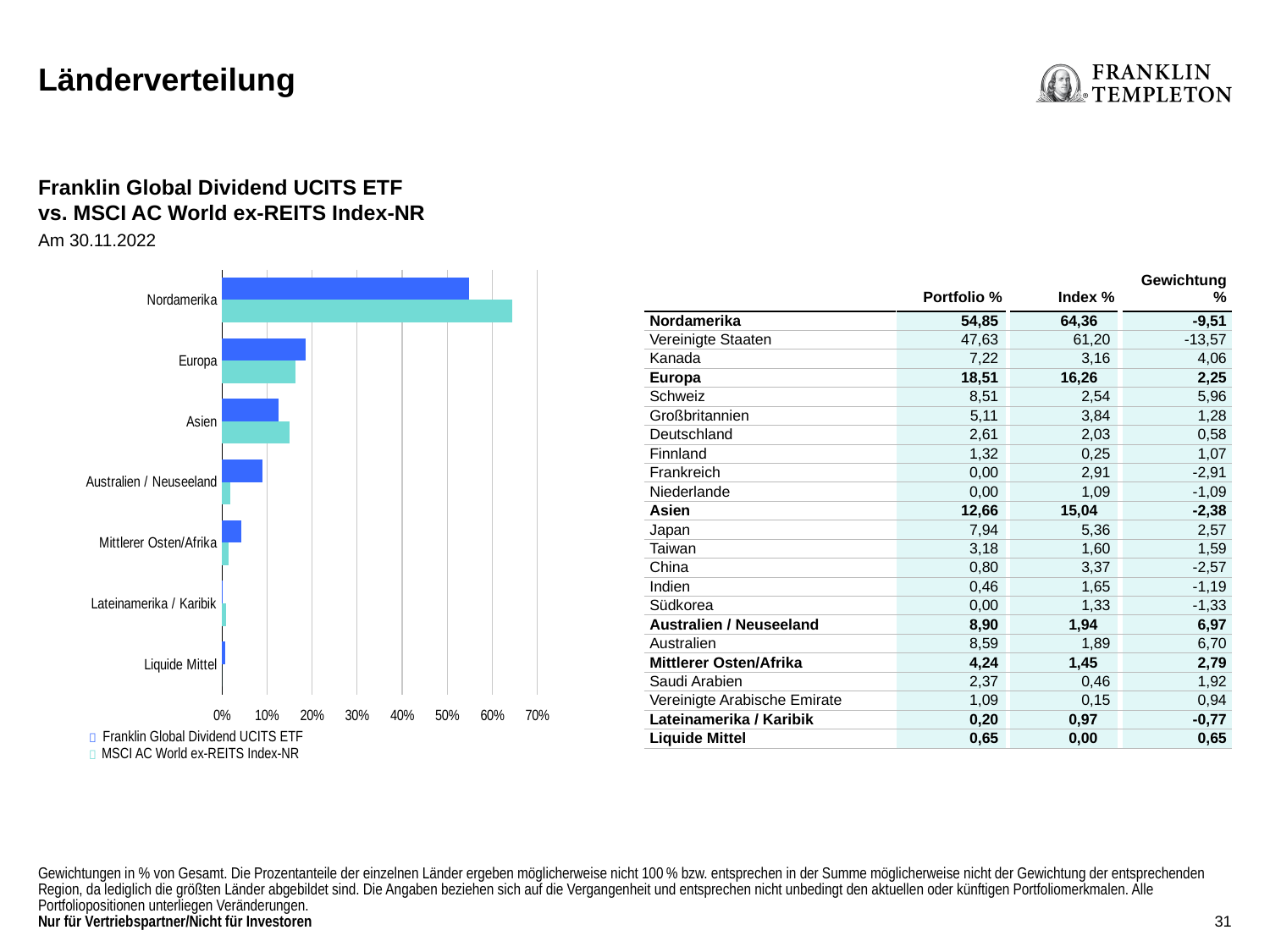
What kind of chart is shown on the slide? bar chart Which category has the highest value for Franklin Global Dividend UCITS ETF? Nordamerika For Australien / Neuseeland, which series has the larger value: Franklin Global Dividend UCITS ETF or MSCI AC World ex-REITS Index-NR? Franklin Global Dividend UCITS ETF Is the value for Nordamerika in the Franklin Global Dividend UCITS ETF series greater or less than 50%? greater According to the table on the slide, what is the Index % for Asien? 15,04 Is the value for Europa in the Franklin Global Dividend UCITS ETF series greater or less than 20%? less According to the table on the slide, what is the Portfolio % for Nordamerika? 54,85 Is the value for Nordamerika in the MSCI AC World ex-REITS Index-NR series greater or less than 60%? greater For Asien, which series has the larger value: Franklin Global Dividend UCITS ETF or MSCI AC World ex-REITS Index-NR? MSCI AC World ex-REITS Index-NR Which series is shown in blue in the chart? Franklin Global Dividend UCITS ETF How many series does the chart legend list? 2 How many categories are plotted on the chart? 7